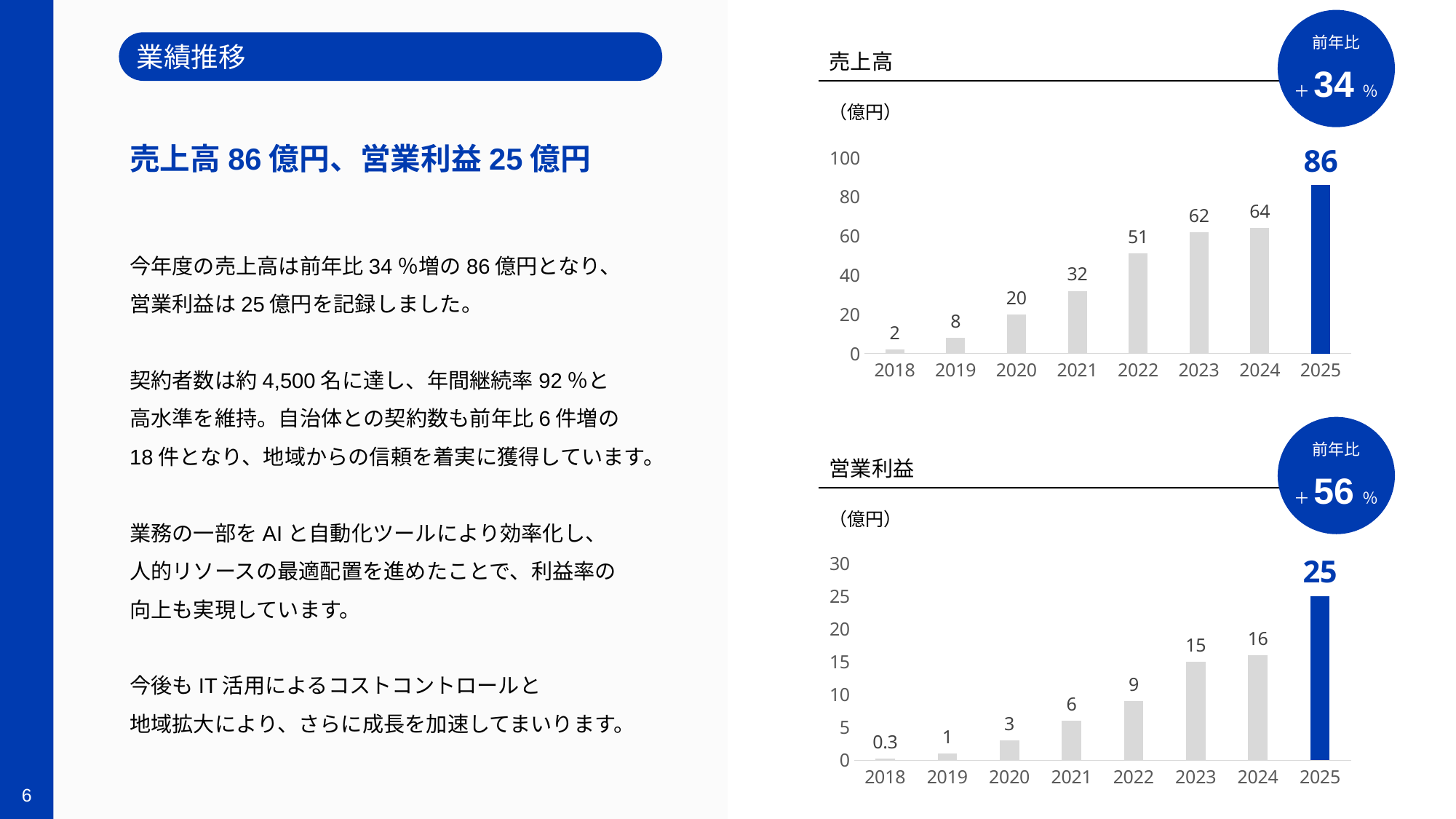
In the 営業利益 chart, what is the value for 2018? 0.3 In the 売上高 chart, do the values rise or fall from 2018 to 2025? rise In the 営業利益 chart, which year has the lowest value? 2018 In the 売上高 chart, how many years are plotted? 8 In the 営業利益 chart, what is the difference between the 2025 and 2024 values? 9 In the 売上高 chart, what is the difference between the 2025 and 2024 values? 22 What kind of chart is the 営業利益 chart? bar chart In the 営業利益 chart, which is larger, the value for 2022 or the value for 2023? 2023 In the 売上高 chart, what is the value for 2022? 51 In the 売上高 chart, which year has the highest value? 2025 In the 売上高 chart, what year-on-year change is shown in the circle badge? +34% In the 営業利益 chart, what unit is shown below the title? 億円